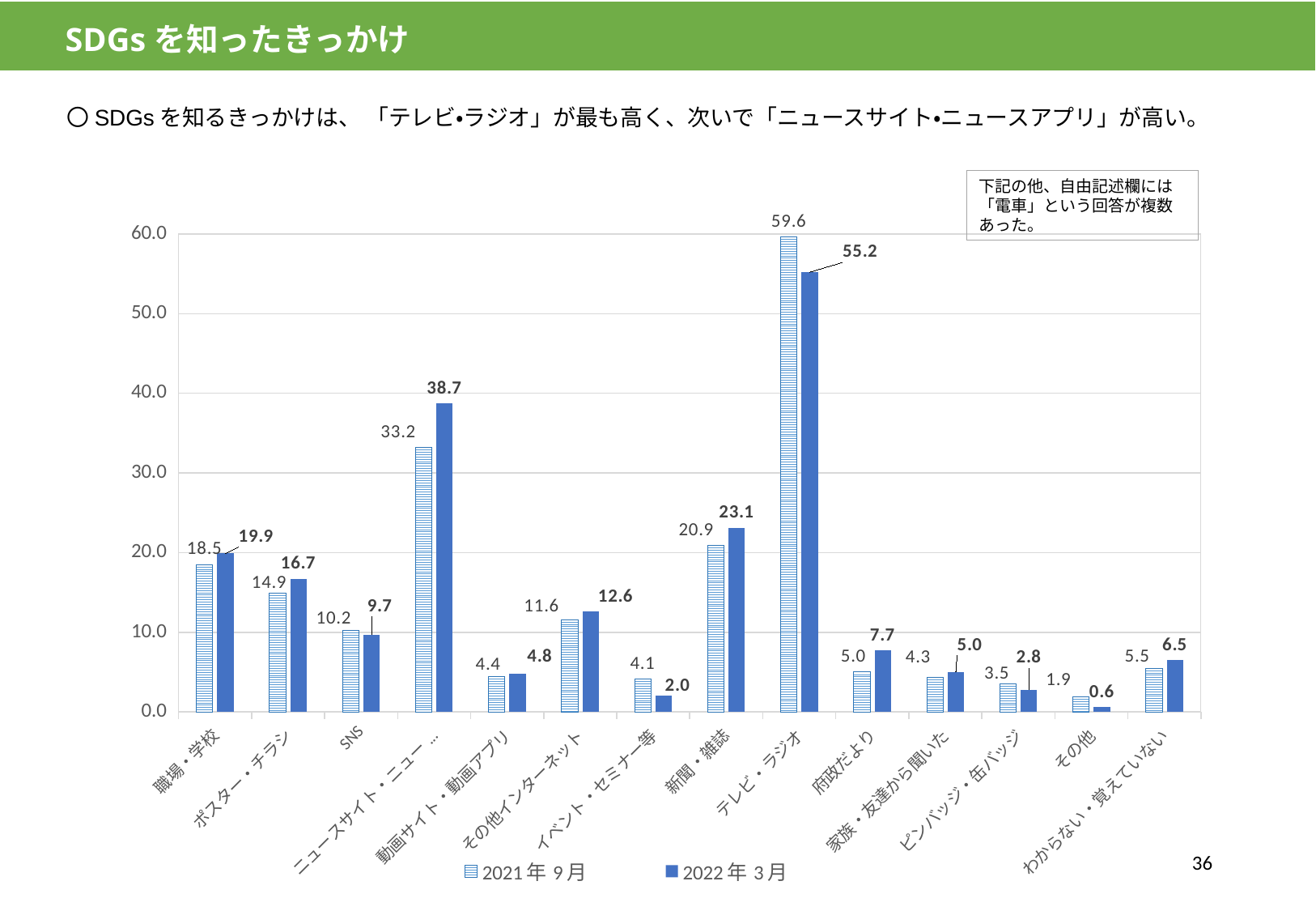
What type of chart is shown on the slide? Bar chart Is the 2022年3月 value for 職場・学校 greater or less than 10.0? greater For 府政だより, which series has the larger value, 2021年9月 or 2022年3月? 2022年3月 What is the value for SNS in the 2021年9月 series? 10.2 How many categories are shown on the x axis? 14 What is the value for 新聞・雑誌 in the 2022年3月 series? 23.1 Which category has the highest value in the 2022年3月 series? テレビ・ラジオ What is the value for テレビ・ラジオ in the 2021年9月 series? 59.6 What is the difference between the 2021年9月 and 2022年3月 values for テレビ・ラジオ? 4.4 What is the title of the slide containing the chart? SDGs を知ったきっかけ How many series does the legend list? 2 Which category has the lowest value in the 2022年3月 series? その他